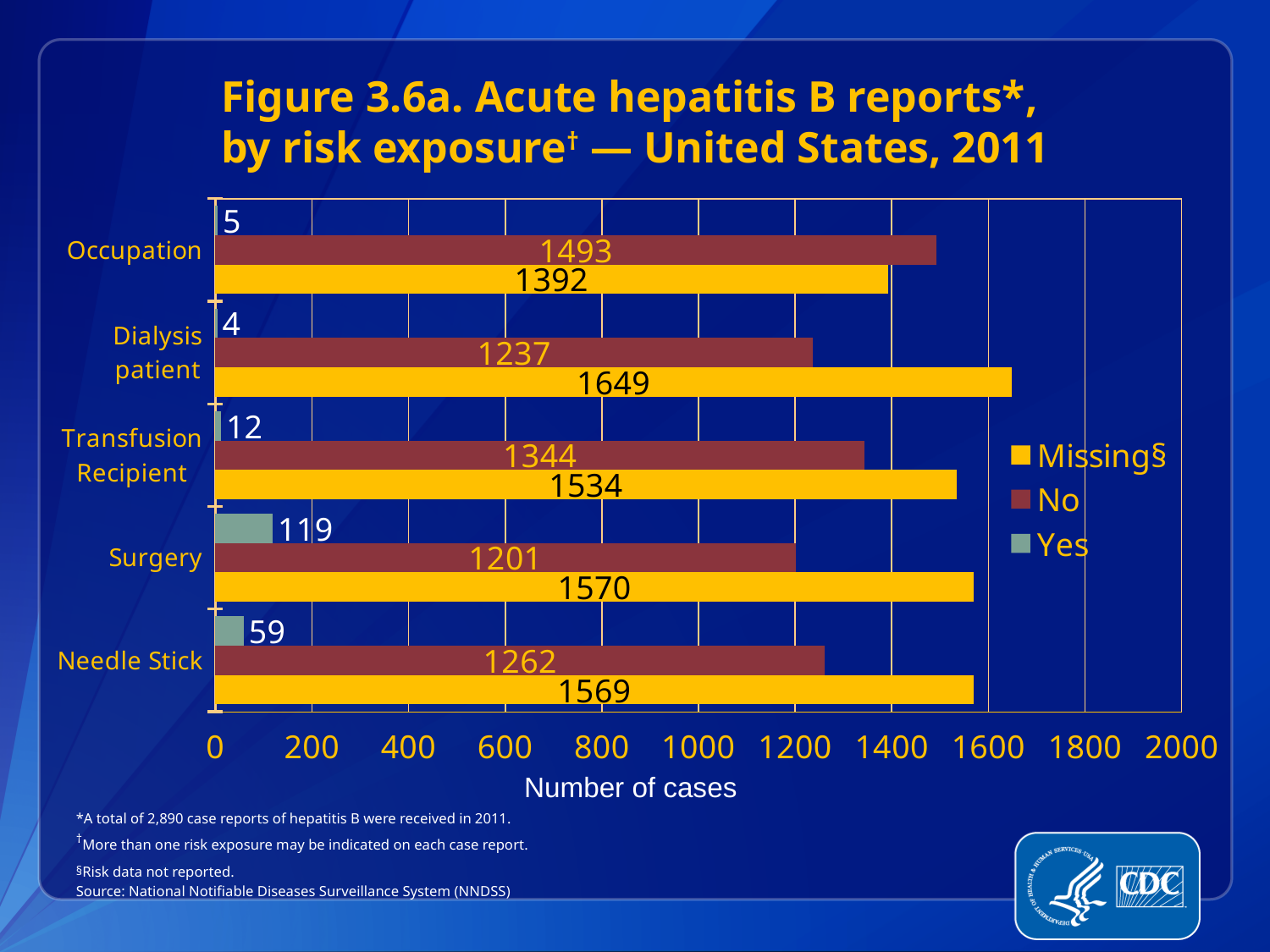
Which risk exposure has the highest value in the Yes series? Surgery How many risk exposure categories are shown on the chart? 5 Which risk exposure has the lowest value in the Missing series? Occupation Which is larger for Transfusion Recipient: the No value or the Missing value? Missing What is the number of cases for Occupation in the No series? 1493 What is the number of cases for Surgery in the Yes series? 119 How many series does the legend list? 3 What is the number of cases for Needle Stick in the Yes series? 59 What is the label of the x axis? Number of cases What kind of chart is shown on the slide? Bar chart What is the number of cases for Dialysis patient in the Missing series? 1649 What is the difference between the No and Yes values for Needle Stick? 1203